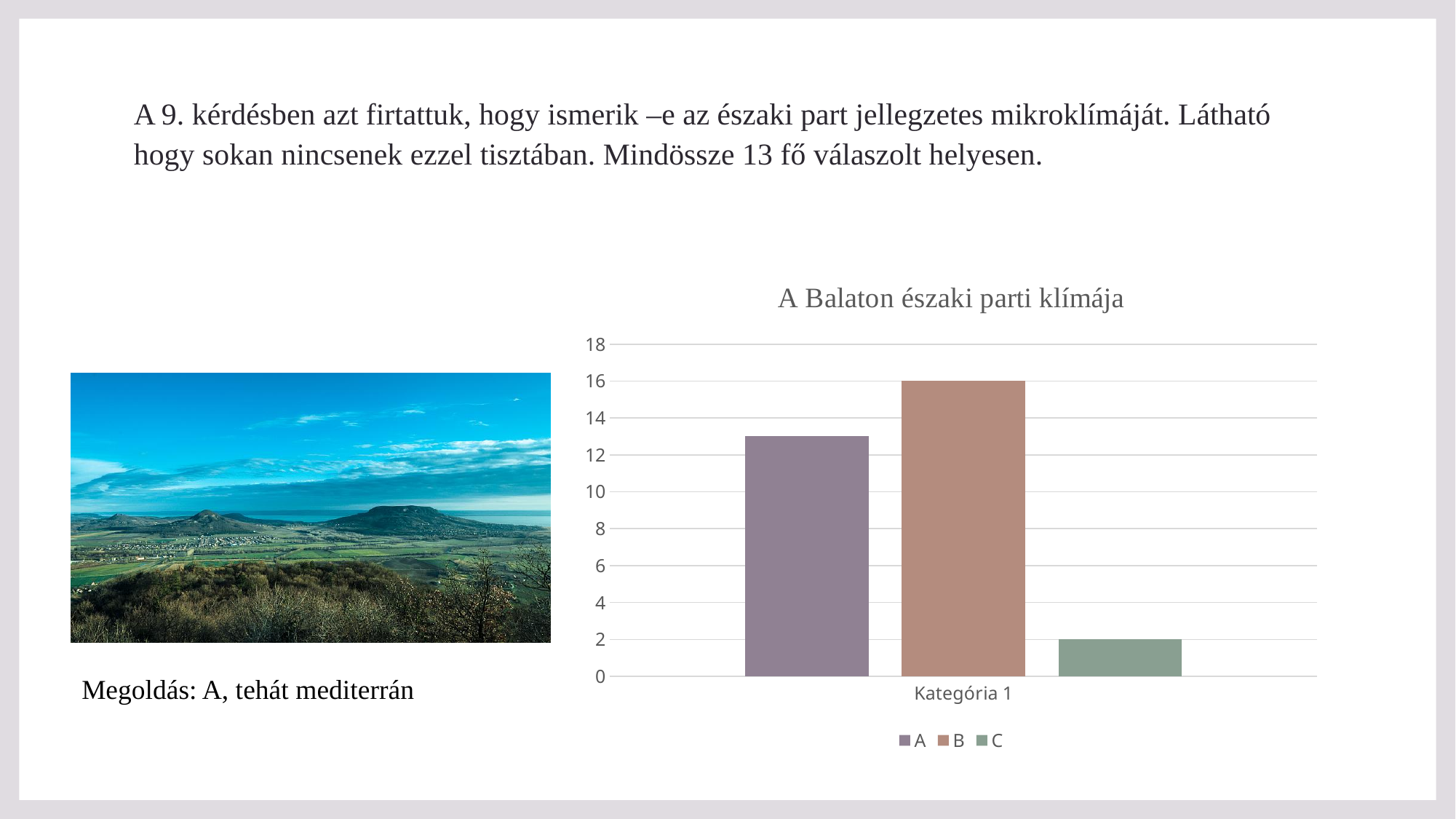
How many categories are shown on the x axis of the chart? 1 How many series does the chart legend list? 3 What is the value of series C in the chart? 2 Which series has the lowest value in the chart? C What kind of chart is shown on the slide? bar chart Which series has the highest value in the chart? B What is the difference between the values of series B and series C? 14 Is the value for A greater or less than 12? greater What is the title of the chart? A Balaton északi parti klímája Is the value for A greater or less than 14? less Which is larger in the chart, the value for A or the value for B? B What is the value of series B in the chart? 16